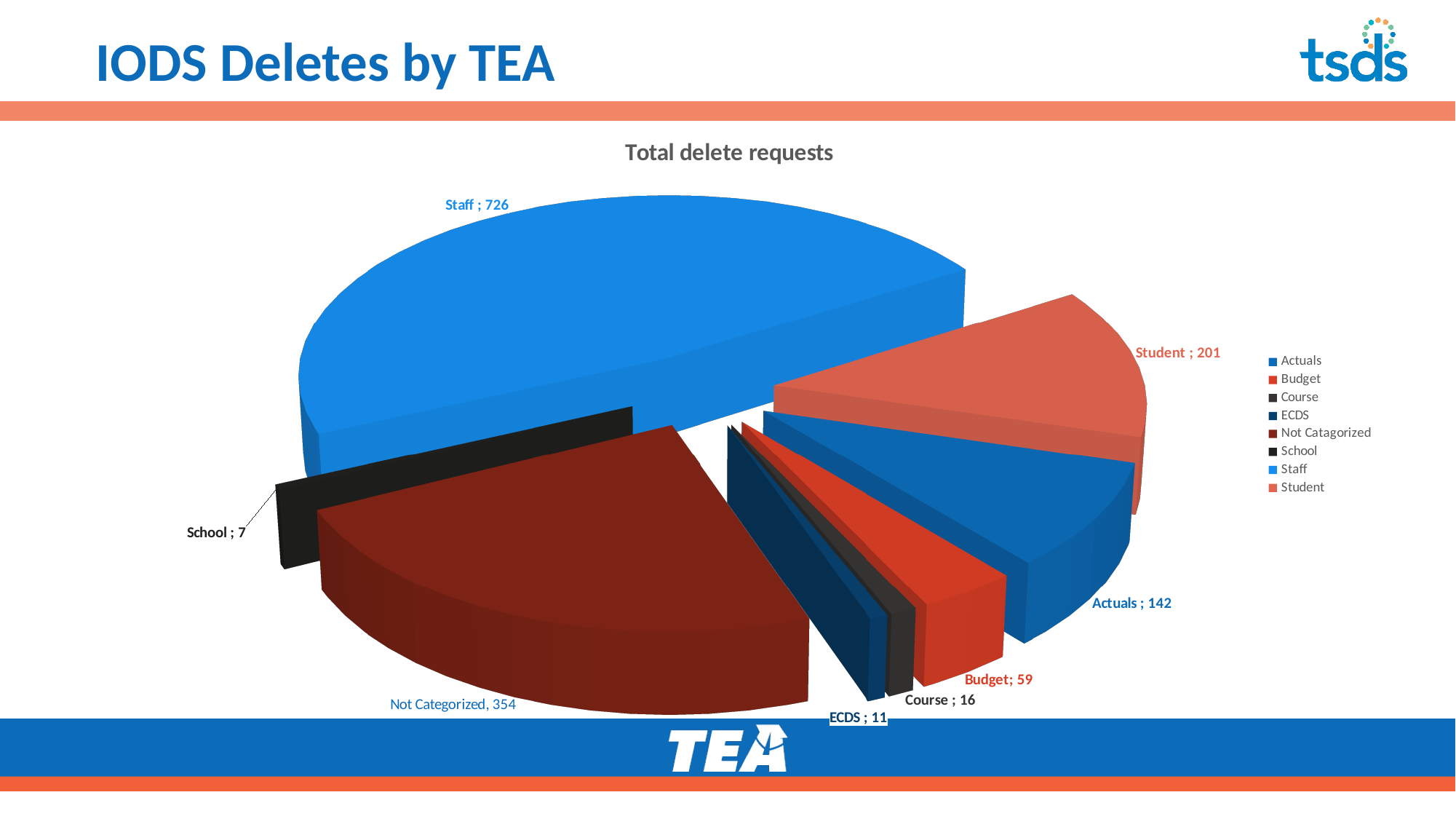
Which is larger, the value for Course or the value for ECDS? Course How many delete requests are shown for Staff? 726 What share of the total delete requests does Staff represent? 47.9% What is the value for Not Categorized? 354 Which category has the highest number of delete requests? Staff What is the value for Budget? 59 Which category has the lowest number of delete requests? School What is the difference between the Student and Actuals values? 59 How many categories does the pie chart have? 8 What is the title of the chart? Total delete requests What kind of chart is shown on the slide? Pie chart What is the total of all delete requests shown in the chart? 1516